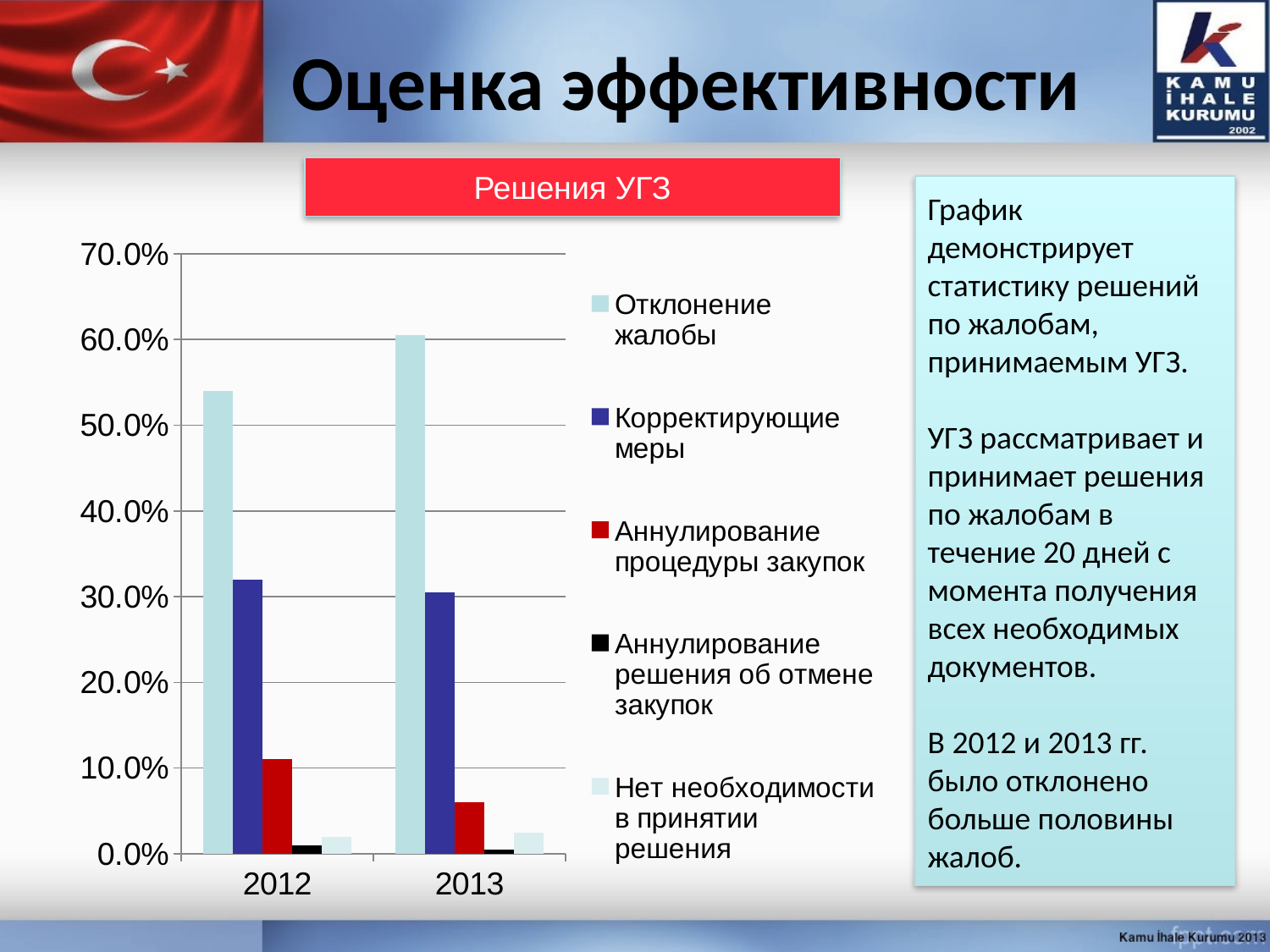
How many series does the legend list? 5 Which series has the lowest value in 2013? Аннулирование решения об отмене закупок Does the value for Аннулирование процедуры закупок rise or fall from 2012 to 2013? fall What kind of chart is shown on the slide? bar chart Which is larger: Отклонение жалобы in 2012 or Отклонение жалобы in 2013? 2013 What is the title of the chart? Решения УГЗ How many year categories are shown on the x axis? 2 Which colour represents Корректирующие меры in the legend? dark blue Is the value for Аннулирование процедуры закупок in 2013 greater or less than 10.0%? less Is the value for Отклонение жалобы in 2012 greater or less than 50.0%? greater Which series has the highest value in 2012? Отклонение жалобы